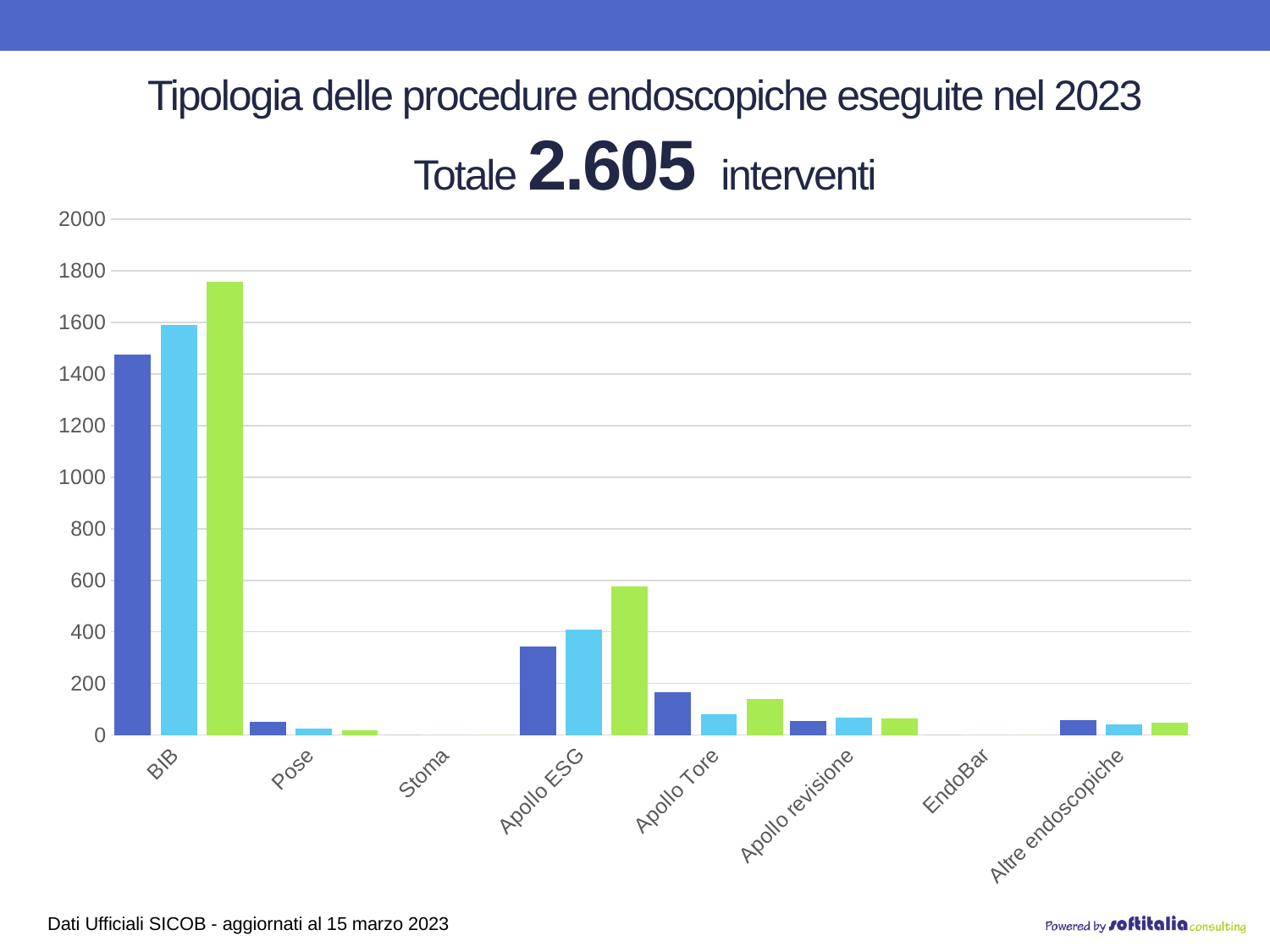
Which category has the tallest bars in the chart? BIB What is the title of the chart? Tipologia delle procedure endoscopiche eseguite nel 2023 Is the value of the green bar for BIB greater or less than 1600? greater Which category has higher bars, Apollo ESG or Apollo Tore? Apollo ESG Which category has higher bars, BIB or Apollo ESG? BIB Is the value of the dark blue bar for BIB greater or less than 1600? less What total number of interventions is stated above the chart? 2.605 Is the value of the dark blue bar for Apollo ESG greater or less than 400? less How many categories are shown on the x axis of the chart? 8 What kind of chart is shown on the slide? bar chart